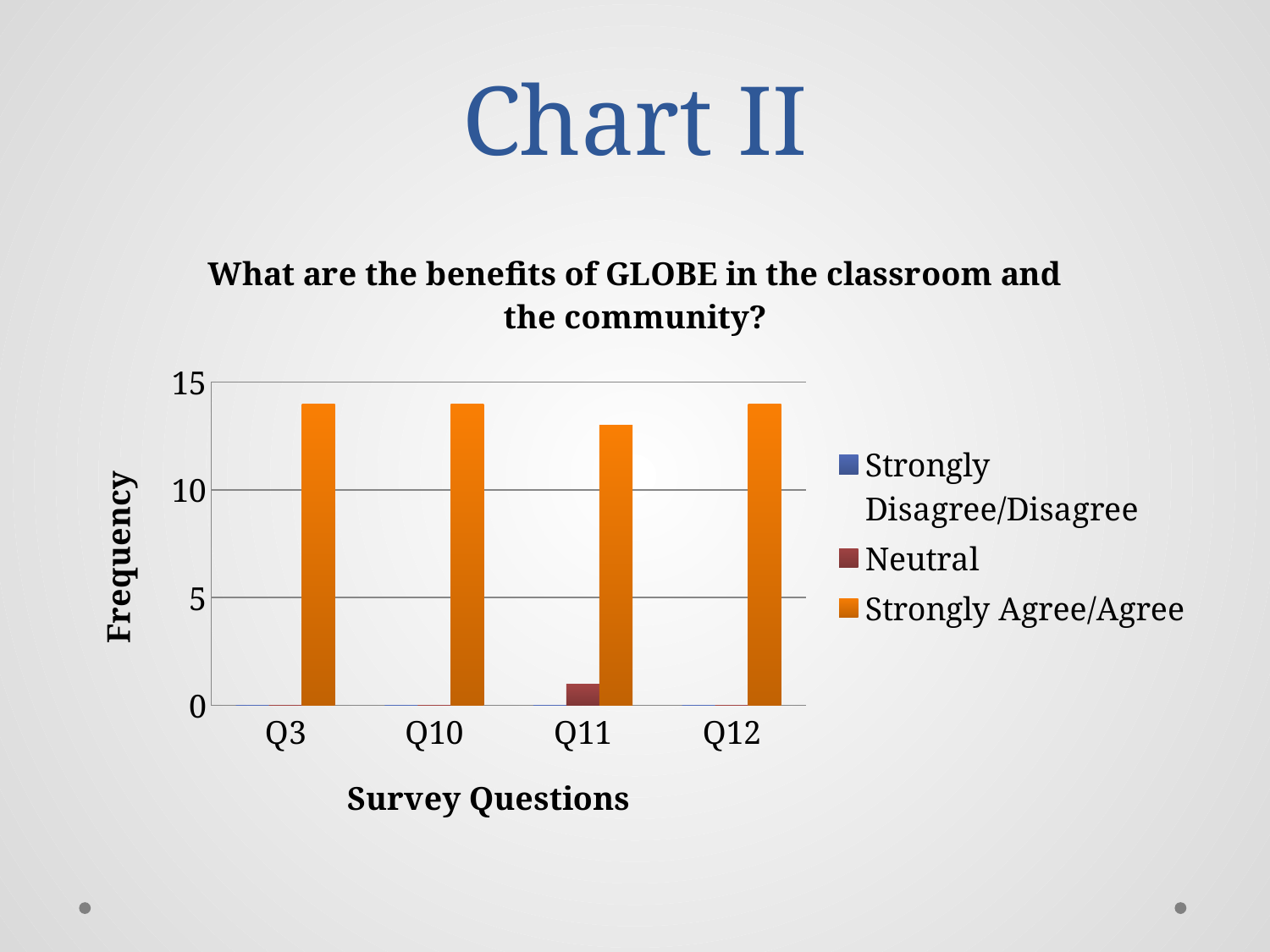
What kind of chart is shown on the slide? bar chart Is the Neutral value for Q11 greater or less than 5? less For Q11, which is larger: the Strongly Agree/Agree value or the Neutral value? Strongly Agree/Agree Is the Strongly Agree/Agree value for Q12 greater or less than 10? greater Which survey question is the only one with a visible Neutral bar? Q11 What is the label of the y axis? Frequency How many series does the legend list? 3 Is the Strongly Agree/Agree value for Q3 greater or less than 10? greater How many survey questions are shown on the x axis? 4 Which survey question has the lowest Strongly Agree/Agree value? Q11